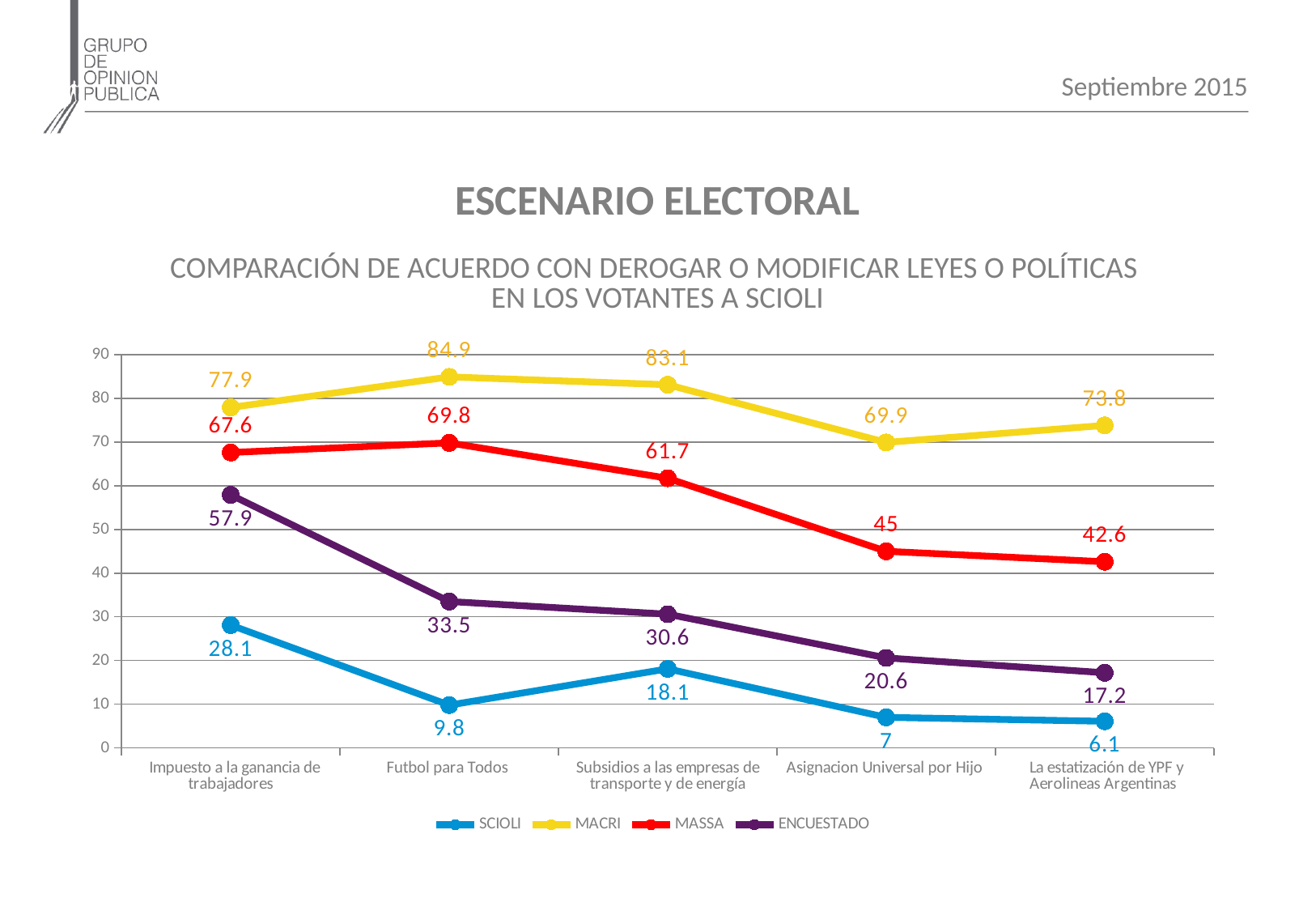
What is the value for SCIOLI at Asignacion Universal por Hijo? 7 Which is larger at Futbol para Todos: the ENCUESTADO value or the SCIOLI value? ENCUESTADO For which category is the SCIOLI series lowest? La estatización de YPF y Aerolineas Argentinas Does the MASSA series rise or fall from Futbol para Todos to La estatización de YPF y Aerolineas Argentinas? fall What is the value for MASSA at La estatización de YPF y Aerolineas Argentinas? 42.6 How many categories are shown on the x axis? 5 What is the difference between the MACRI and MASSA values at Subsidios a las empresas de transporte y de energía? 21.4 What is the value for ENCUESTADO at Impuesto a la ganancia de trabajadores? 57.9 For which category is the MACRI series highest? Futbol para Todos What kind of chart is shown on the slide? line chart What is the value for MACRI at Futbol para Todos? 84.9 How many series does the legend list? 4